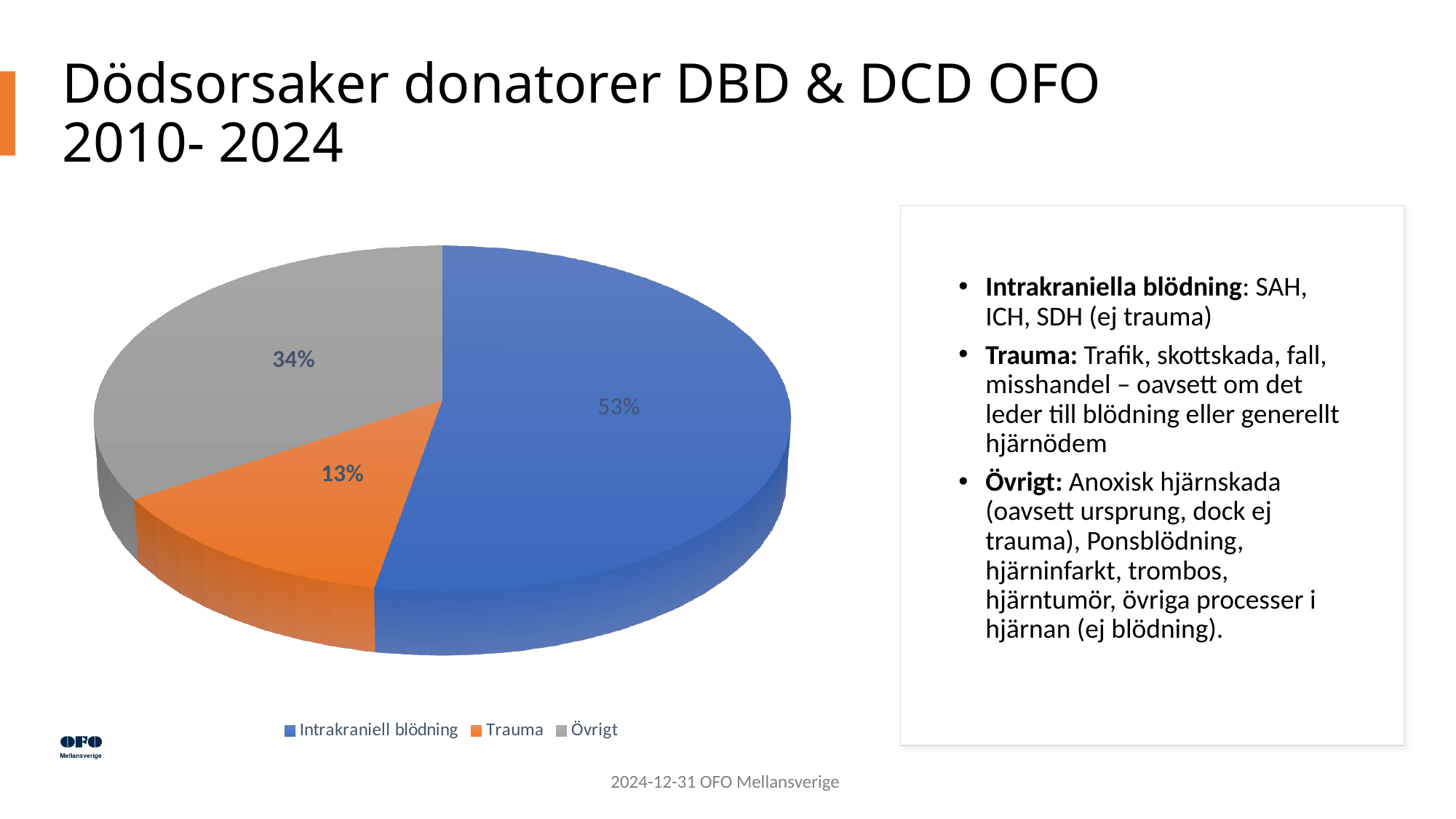
What colour is the Trauma slice in the pie chart? Orange Which category has the largest slice of the pie chart? Intrakraniell blödning What share of the pie chart is Trauma? 13% What kind of chart is shown on the slide? Pie chart What share of the pie chart is Intrakraniell blödning? 53% What is the difference in percentage points between Övrigt and Trauma? 21 Which is larger, the share for Övrigt or the share for Trauma? Övrigt What is the title of the slide containing the pie chart? Dödsorsaker donatorer DBD & DCD OFO 2010- 2024 What share of the pie chart is Övrigt? 34% How many categories does the pie chart show? 3 Which category has the smallest slice of the pie chart? Trauma What is the difference in percentage points between Intrakraniell blödning and Övrigt? 19